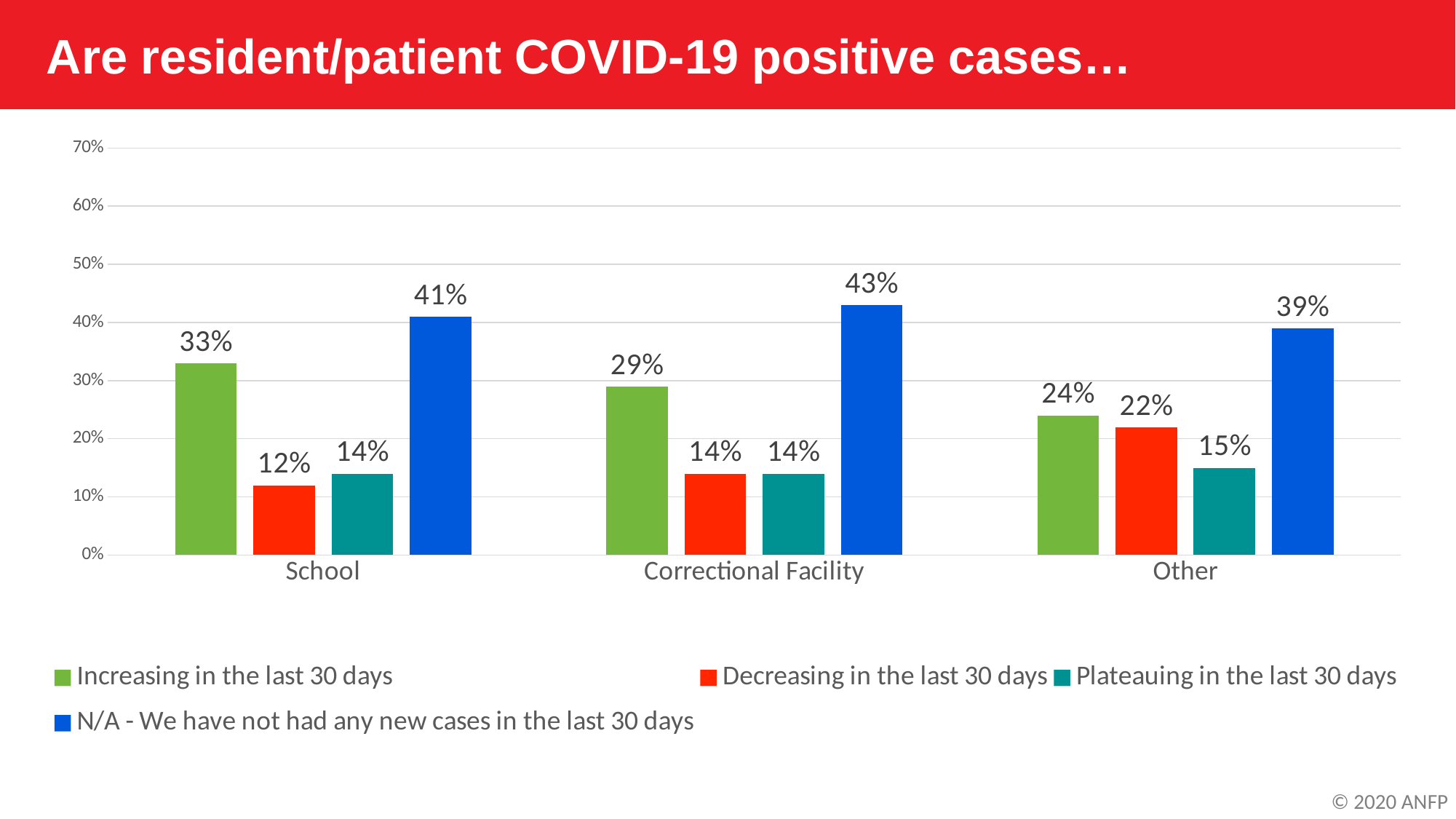
What percentage of Other respondents reported cases decreasing in the last 30 days? 22% Which category has the lowest value for 'Decreasing in the last 30 days'? School Is the 'N/A - We have not had any new cases in the last 30 days' value for Other greater or less than 30%? greater What is the value for 'N/A - We have not had any new cases in the last 30 days' for Correctional Facility? 43% What colour represents 'Plateauing in the last 30 days' in the legend? Teal What is the difference between the 'Increasing in the last 30 days' values for School and Other? 9% How many series does the legend list? 4 What kind of chart is shown on the slide? Bar chart Which is larger: the 'Plateauing in the last 30 days' value for Other or for School? Other Which category has the highest value for 'N/A - We have not had any new cases in the last 30 days'? Correctional Facility How many categories are shown on the x axis? 3 What percentage of School respondents reported cases increasing in the last 30 days? 33%